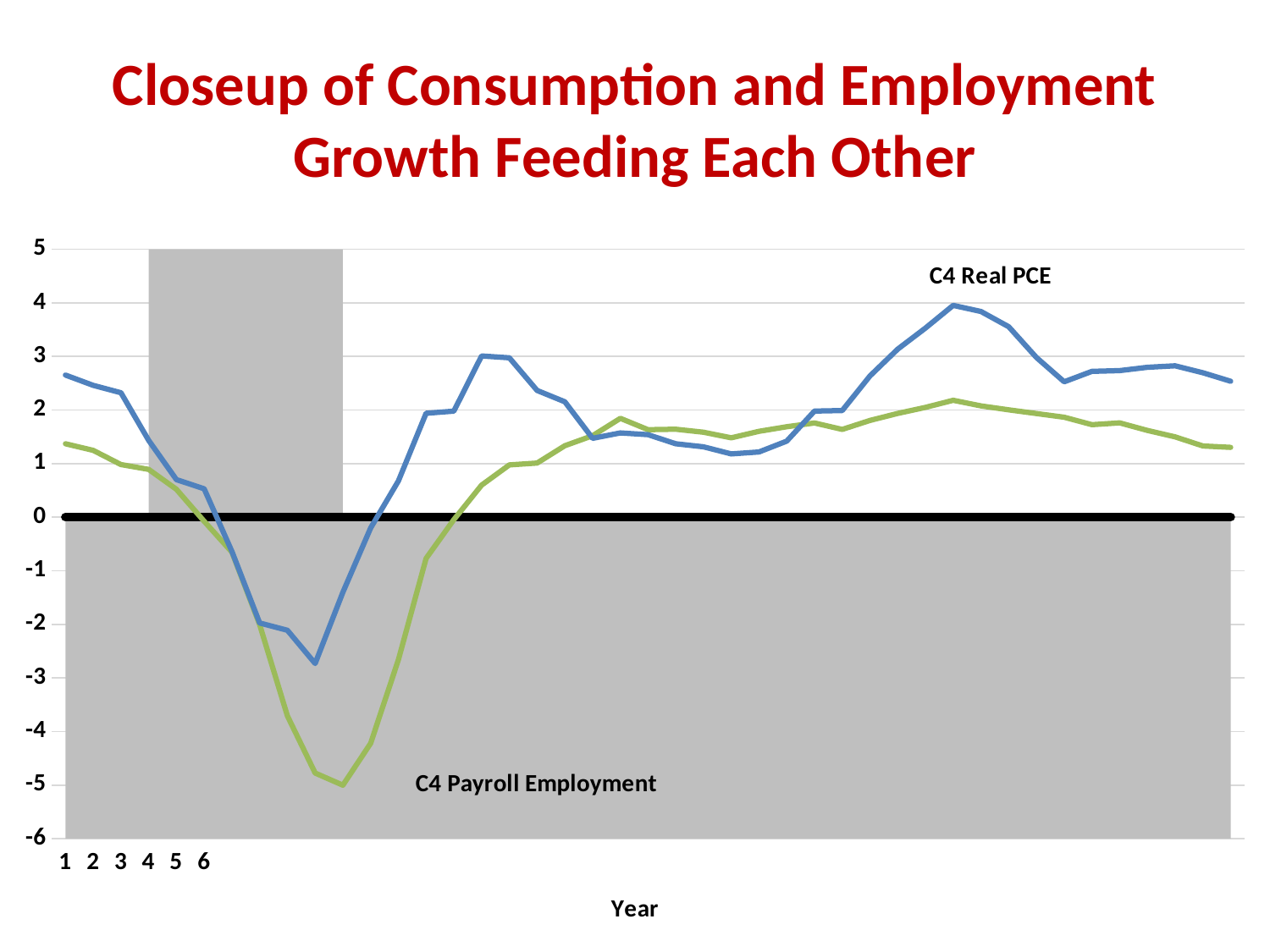
Is the lowest value of C4 Payroll Employment greater or less than -4? less What is the title of the x axis? Year Is the highest value of C4 Payroll Employment greater or less than 3? less At year 1, which series has the higher value, C4 Real PCE or C4 Payroll Employment? C4 Real PCE From year 1 to year 6, does C4 Real PCE rise or fall? fall Which series reaches the lowest value on the chart, C4 Real PCE or C4 Payroll Employment? C4 Payroll Employment How many data series are plotted on the chart? 2 Is the highest value of C4 Real PCE greater or less than 3? greater What kind of chart is shown on the slide? line chart What are the two series on the chart labeled? C4 Real PCE and C4 Payroll Employment